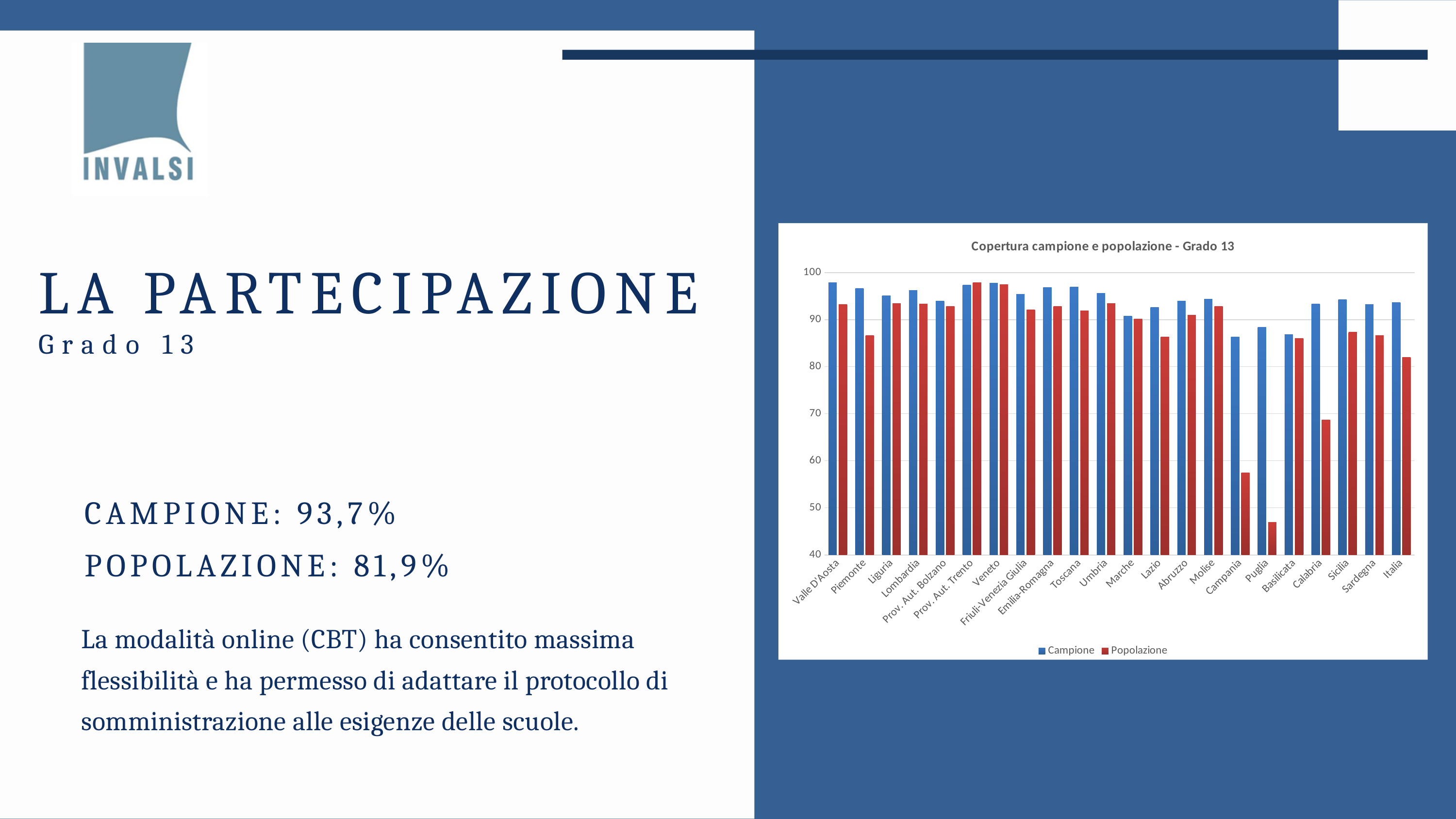
How many series does the chart legend list? 2 For Italia, which is larger: the Campione value or the Popolazione value? Campione What is the title of the chart? Copertura campione e popolazione - Grado 13 What kind of chart is shown on the slide? bar chart For Campania, which is larger: the Campione value or the Popolazione value? Campione Which category has the lowest Popolazione value? Puglia Is the Popolazione value for Puglia greater or less than 50? less Is the Popolazione value for Campania greater or less than 60? less Is the Campione value for Valle D'Aosta greater or less than 90? greater How many categories are shown on the x axis of the chart? 22 Which series is shown in red in the chart? Popolazione